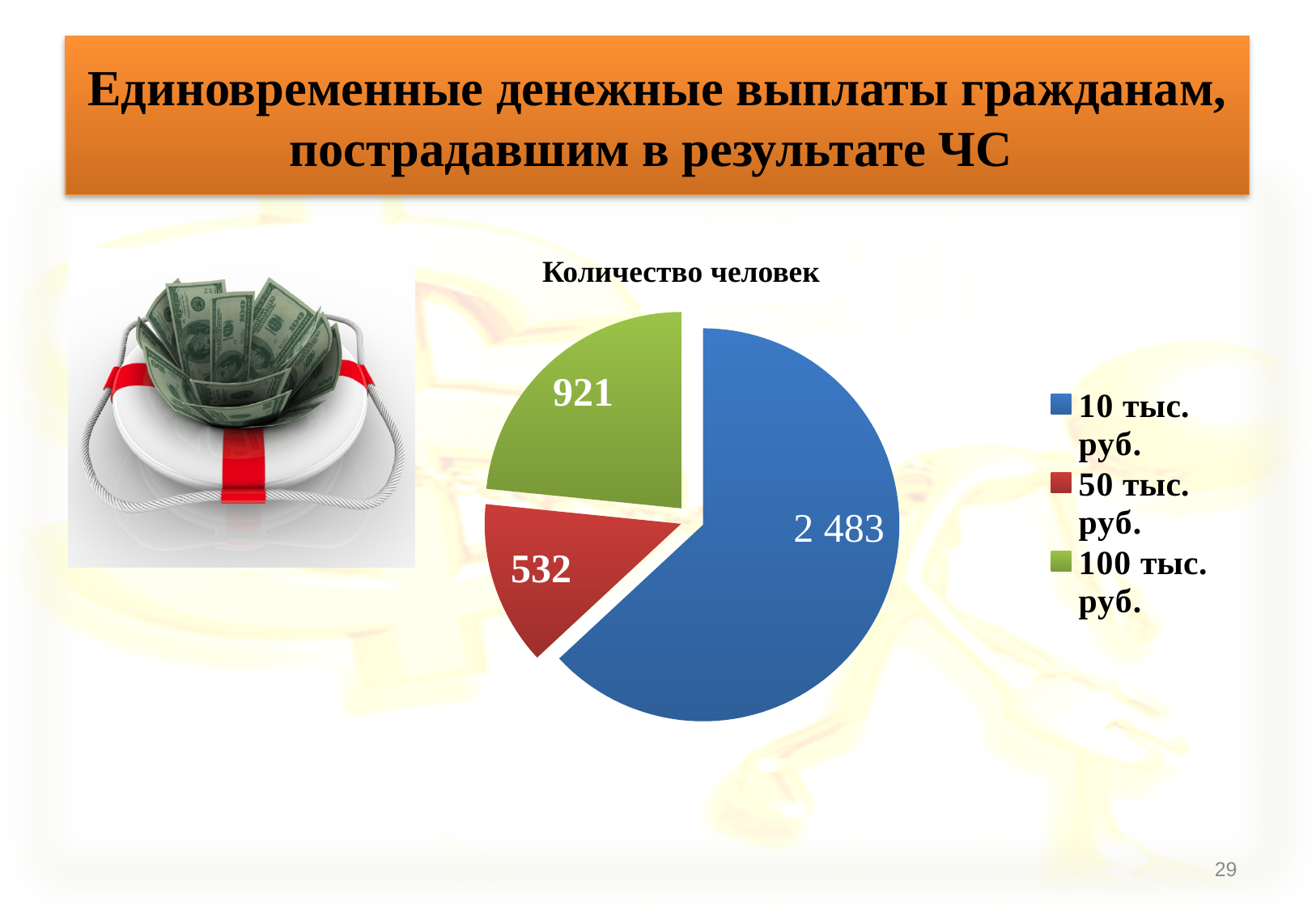
What is the value for the 100 тыс. руб. slice? 921 What is the title of the chart? Количество человек Which is larger, the value for 100 тыс. руб. or the value for 50 тыс. руб.? 100 тыс. руб. What kind of chart is shown on the slide? pie chart What is the value for the 10 тыс. руб. slice? 2 483 What is the value for the 50 тыс. руб. slice? 532 Which category has the largest slice? 10 тыс. руб. What is the difference between the values for 10 тыс. руб. and 100 тыс. руб.? 1 562 How many slices does the pie chart have? 3 Which category has the smallest slice? 50 тыс. руб. How many entries does the legend list? 3 What colour is the slice for 100 тыс. руб.? green